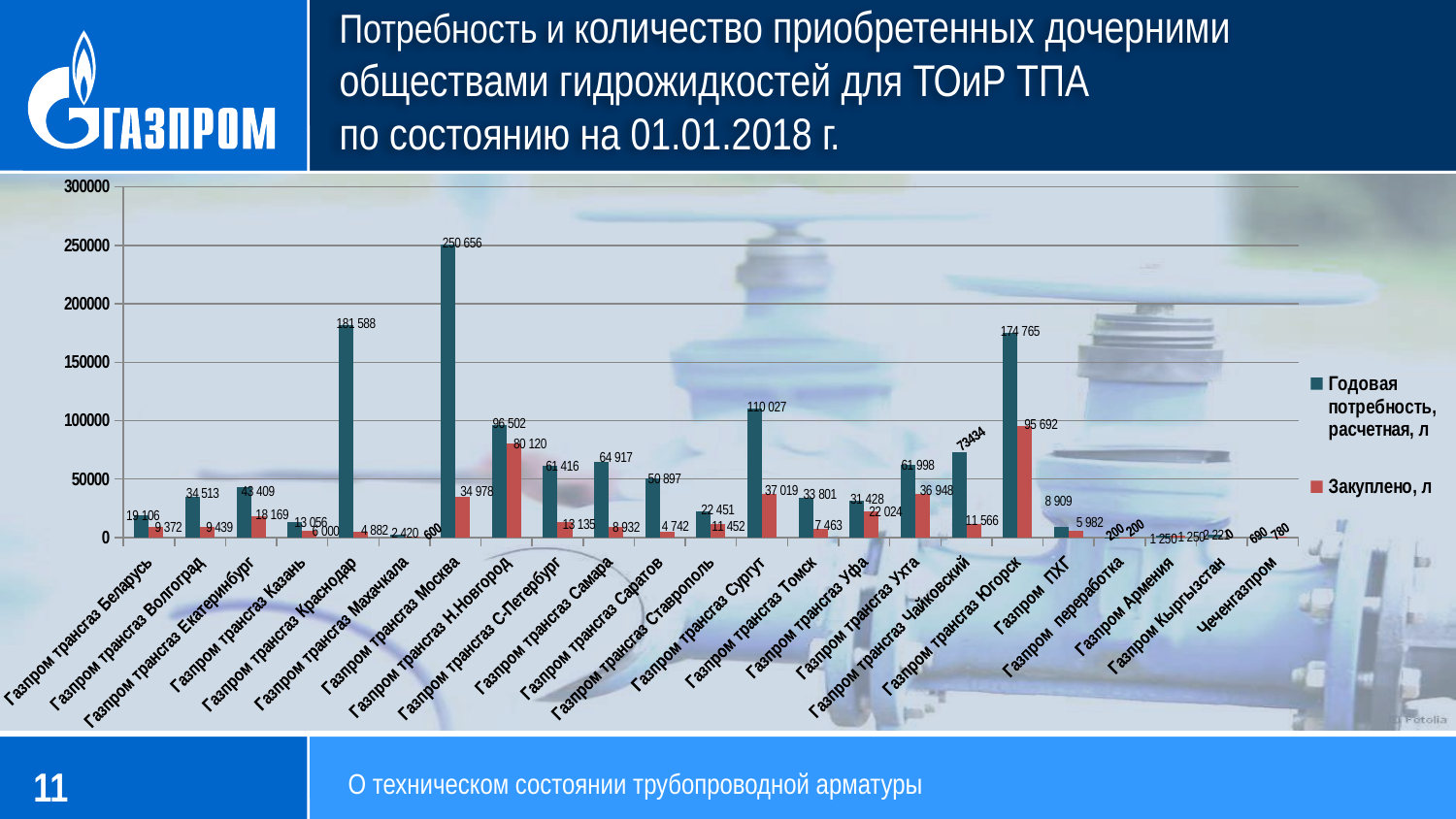
Which is larger for Газпром трансгаз Н.Новгород: the annual calculated demand or the purchased volume? Годовая потребность, расчетная, л What is the difference between the annual calculated demand and the purchased volume for Газпром трансгаз Краснодар? 176 706 What is the annual calculated demand (Годовая потребность, расчетная, л) for Газпром ПХГ? 8 909 What is the purchased volume (Закуплено, л) for Газпром трансгаз Югорск? 95 692 How many series does the legend list? 2 Which subsidiary has the highest purchased volume (Закуплено, л)? Газпром трансгаз Югорск Is the annual calculated demand for Газпром трансгаз Сургут greater or less than 100000? greater What is the annual calculated demand (Годовая потребность, расчетная, л) for Газпром трансгаз Москва? 250 656 Which subsidiary has the highest annual calculated demand (Годовая потребность, расчетная, л)? Газпром трансгаз Москва What is the difference between the annual calculated demand and the purchased volume for Газпром трансгаз Ухта? 25 050 What is the purchased volume (Закуплено, л) for Газпром трансгаз Уфа? 22 024 What type of chart is shown on the slide? bar chart